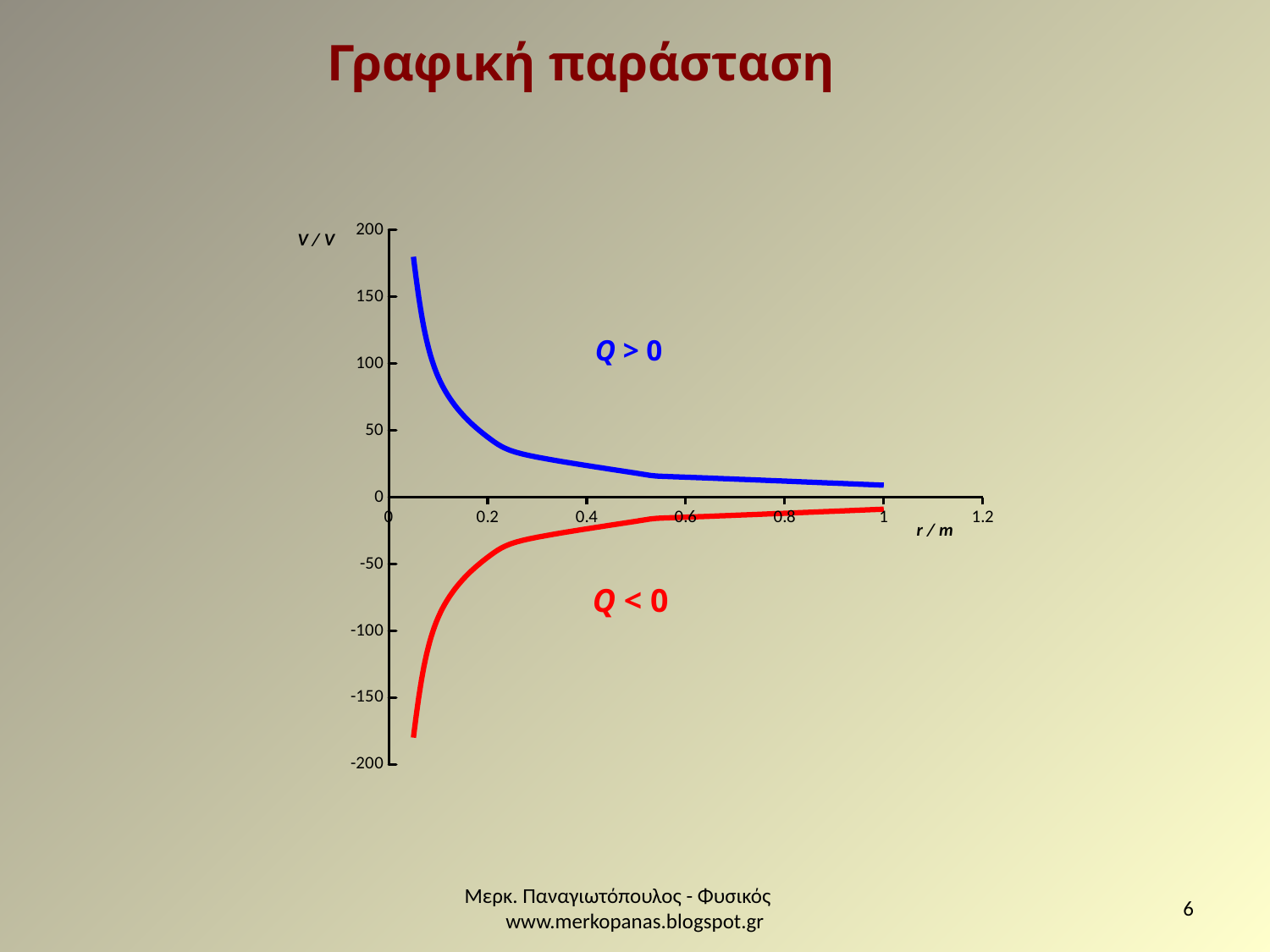
Is the value of the red (Q < 0) curve at r = 0.4 greater or less than -50? greater Is the value of the blue (Q > 0) curve at r = 0.4 greater or less than 50? less How many curves are plotted on the chart? 2 Does the blue (Q > 0) curve rise or fall as r increases? fall What is the highest tick value shown on the vertical axis? 200 What is the label of the horizontal axis? r / m Is the value of the blue (Q > 0) curve at r = 0.1 greater or less than 50? greater Does the red (Q < 0) curve rise or fall as r increases? rise At r = 0.4, which curve has the larger value, the blue (Q > 0) or the red (Q < 0)? blue (Q > 0) Which curve is labelled Q > 0, the blue one or the red one? blue What kind of chart is shown on the slide? line chart